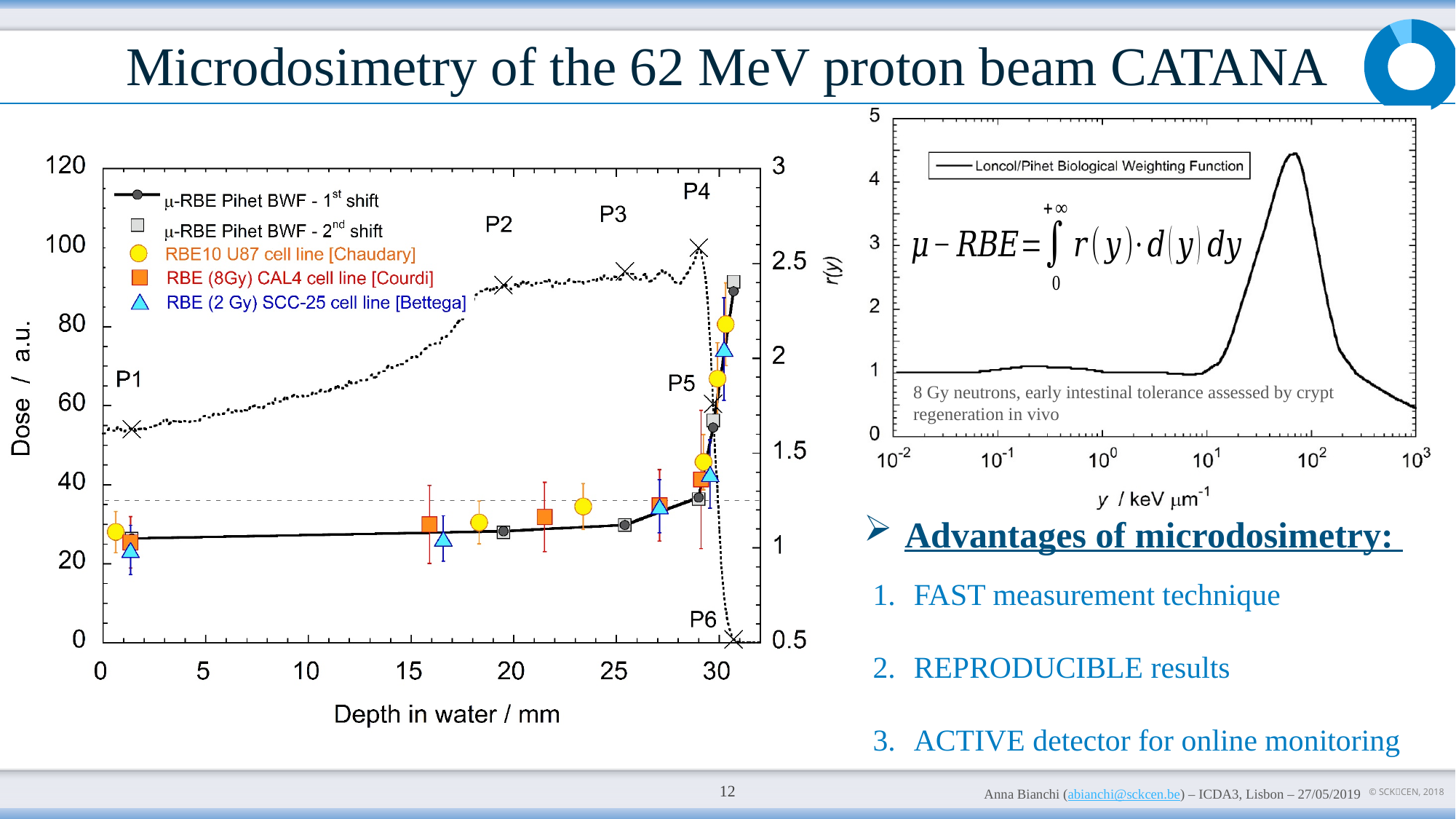
On the left chart, which labelled point has the highest dose? P4 On the left chart, what is the label of the x axis? Depth in water / mm On the left chart, how many labelled points (P1, P2, ...) are marked on the dose curve? 6 On the left chart, is the dose at P1 greater or less than 40? greater On the left chart, which labelled point has the lowest dose? P6 On the right chart, is the peak value of r(y) greater or less than 4? greater On the left chart, how many series does the legend list? 5 On the left chart, between depths of 0 and 25 mm, does the dose curve rise or fall? rise On the left chart, is the dose at P4 greater or less than 80? greater On the right chart, what is the single legend entry? Loncol/Pihet Biological Weighting Function On the left chart, which has the larger dose, P1 or P2? P2 What kind of chart is the left chart? line chart